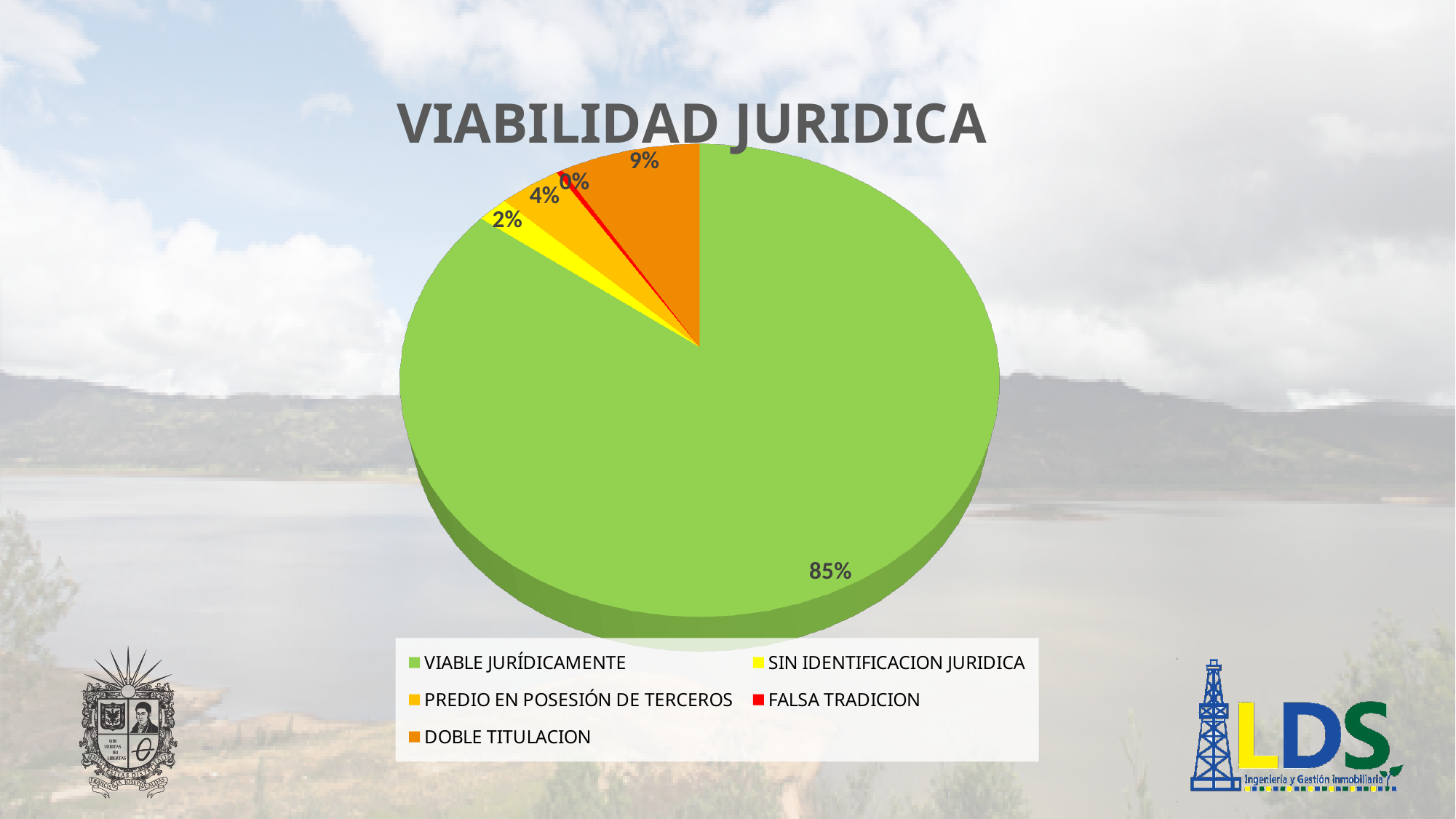
What is the difference in percentage points between VIABLE JURÍDICAMENTE and DOBLE TITULACION? 76 What percentage of the pie is VIABLE JURÍDICAMENTE? 85% What is the title of the chart? VIABILIDAD JURIDICA What percentage of the pie is DOBLE TITULACION? 9% What percentage of the pie is SIN IDENTIFICACION JURIDICA? 2% Which category has the smallest share of the pie? FALSA TRADICION What kind of chart is shown on the slide? pie chart What percentage of the pie is FALSA TRADICION? 0% What percentage of the pie is PREDIO EN POSESIÓN DE TERCEROS? 4% Which category has the largest share of the pie? VIABLE JURÍDICAMENTE Which is larger, the share for DOBLE TITULACION or the share for PREDIO EN POSESIÓN DE TERCEROS? DOBLE TITULACION How many categories does the legend list? 5